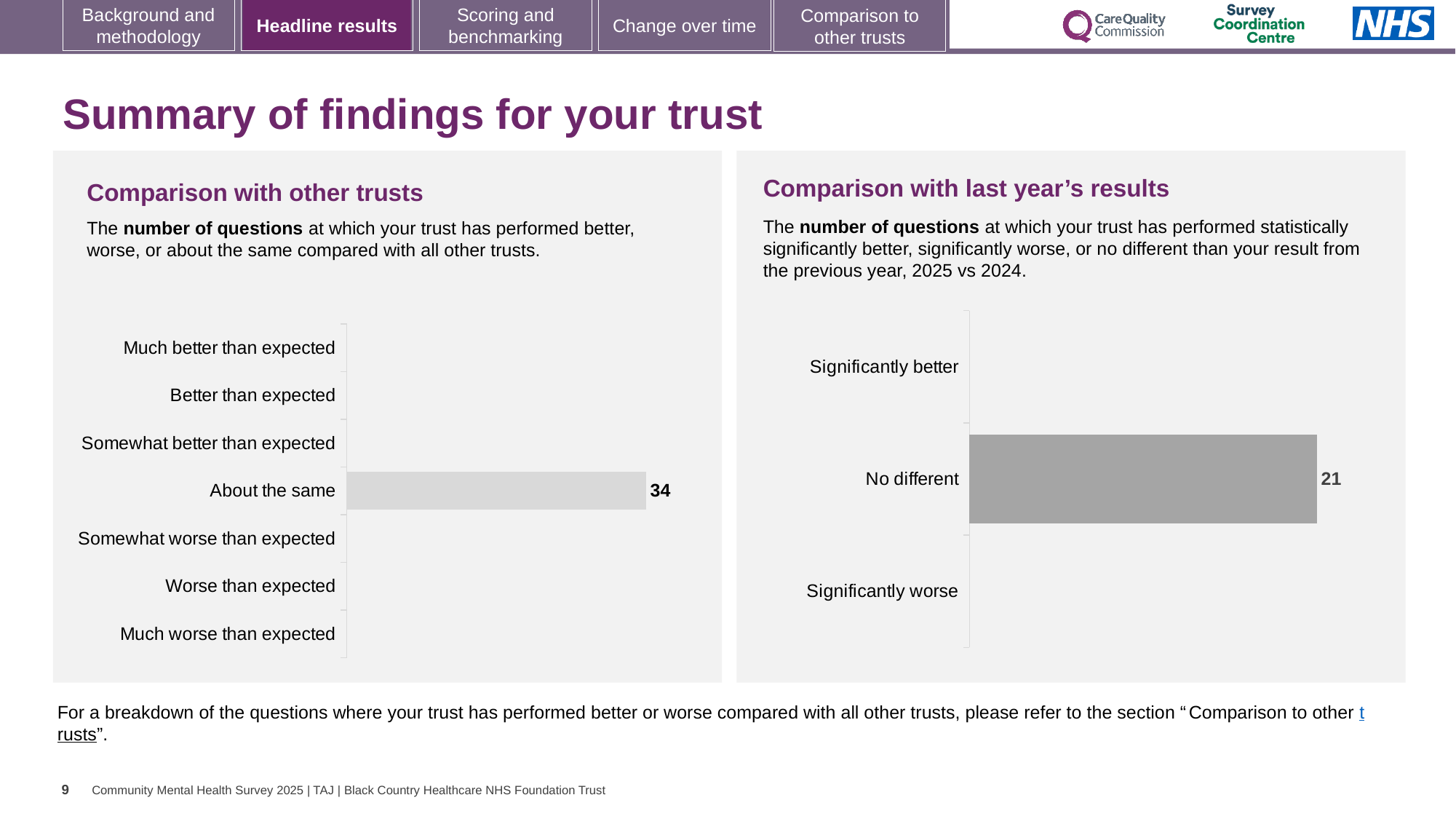
In the 'Comparison with other trusts' chart, how many categories have a visible bar? 1 What is the difference between the 'About the same' value (Comparison with other trusts) and the 'No different' value (Comparison with last year's results)? 13 In the 'Comparison with other trusts' chart, which category has the highest value? About the same How many categories are listed on the y axis of the 'Comparison with other trusts' chart? 7 In the 'Comparison with last year's results' chart, what is the value for 'No different'? 21 What is the title of the chart on the right side of the slide? Comparison with last year's results In the 'Comparison with last year's results' chart, which category has the highest value? No different What kind of chart is the 'Comparison with last year's results' chart? Bar chart What kind of chart is the 'Comparison with other trusts' chart? Bar chart In the 'Comparison with other trusts' chart, what is the value for 'About the same'? 34 Which is larger: the 'About the same' value in the 'Comparison with other trusts' chart or the 'No different' value in the 'Comparison with last year's results' chart? About the same (34) How many categories are listed on the y axis of the 'Comparison with last year's results' chart? 3